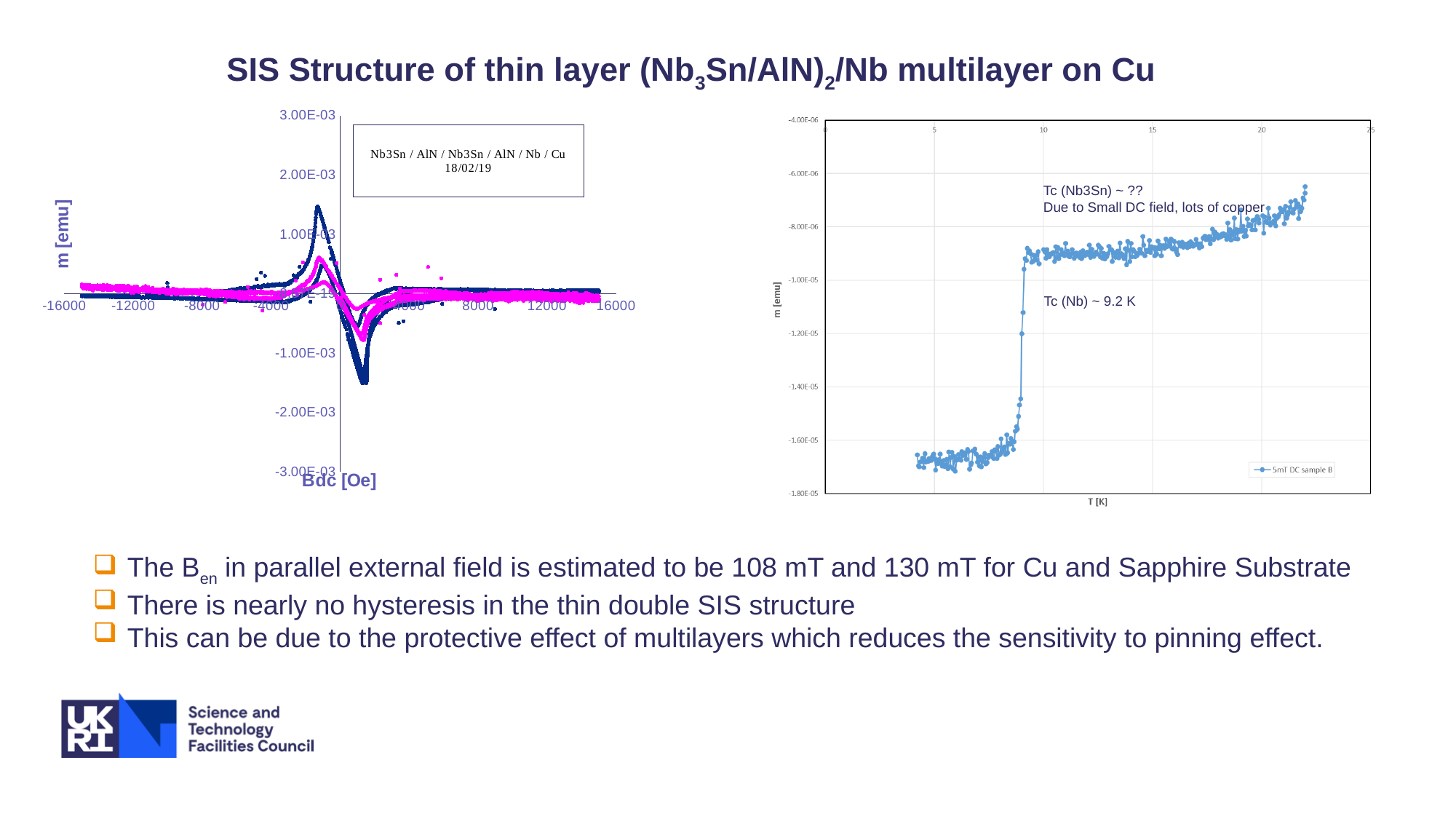
How many series does the legend of the right chart list? 1 What is the maximum value shown on the x axis of the left chart? 16000 In the right chart, do the plotted values rise or fall as temperature increases along the x axis? rise In the right chart, is the value at T = 5 K greater or less than -1.60E-05? less What is the x-axis label of the left chart? Bdc [Oe] What is the lowest tick value shown on the y axis of the right chart? -1.80E-05 In the right chart, is the value at T = 15 K greater or less than -1.00E-05? greater In the left chart, is the peak value of the dark blue series near zero field greater or less than 1.00E-03? greater In the right chart, what transition temperature is annotated for Nb? Tc (Nb) ~ 9.2 K What is the x-axis label of the right chart? T [K] What is the legend entry of the right chart? 5mT DC sample B